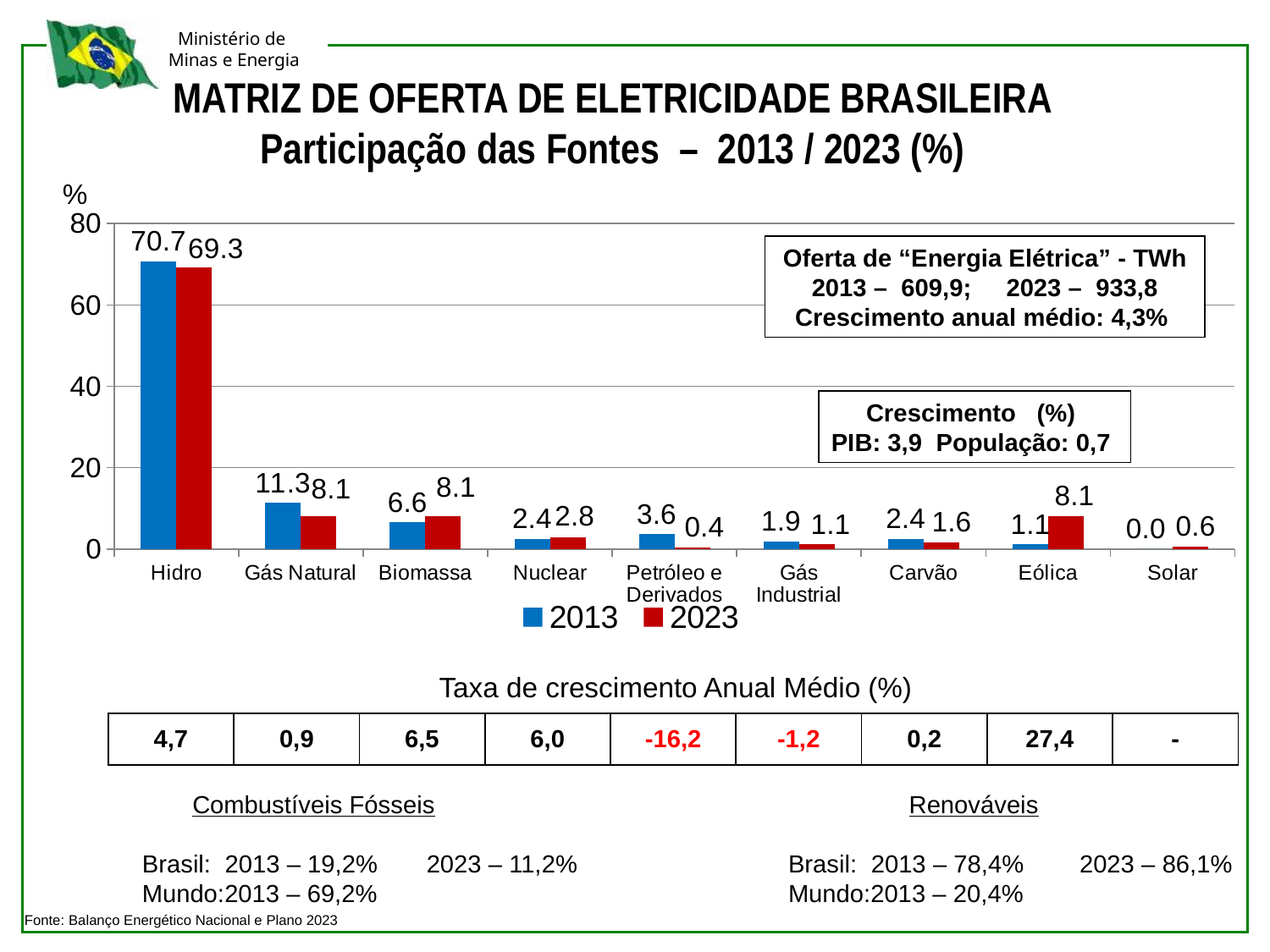
Which category has the lowest 2013 value? Solar How many series does the legend list? 2 What is the 2013 value for Petróleo e Derivados? 3.6 What is the 2013 value for Hidro? 70.7 Is the 2013 value for Hidro greater or less than 60? greater What kind of chart is shown on the slide? bar chart Which is larger for Biomassa, the 2013 value or the 2023 value? 2023 What is the 2023 value for Solar? 0.6 Which category has the highest 2023 value? Hidro How many categories are shown on the x axis? 9 What is the difference between the 2013 and 2023 values for Gás Natural? 3.2 What is the 2023 value for Eólica? 8.1